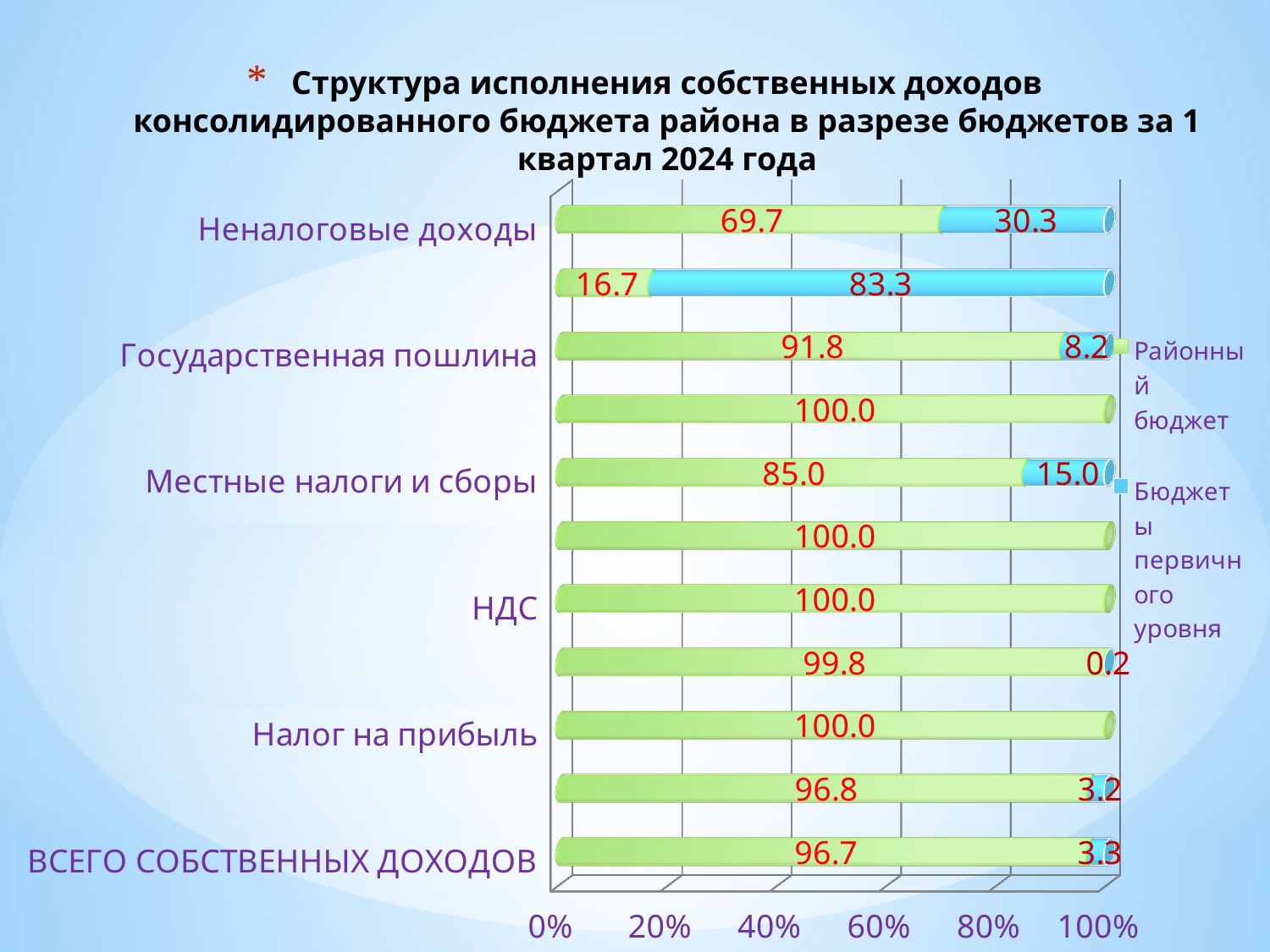
What kind of chart is shown on the slide? Stacked bar chart Among the labeled categories, which has the highest Бюджеты первичного уровня value? Неналоговые доходы What is the value of Районный бюджет for НДС? 100.0 What is the value of Районный бюджет for ВСЕГО СОБСТВЕННЫХ ДОХОДОВ? 96.7 What is the value of Бюджеты первичного уровня for Неналоговые доходы? 30.3 What is the value of Районный бюджет for Местные налоги и сборы? 85.0 What is the total of the stacked bar for Неналоговые доходы? 100.0 How many series does the legend list? 2 What is the value of Бюджеты первичного уровня for Государственная пошлина? 8.2 What is the difference between the Районный бюджет and Бюджеты первичного уровня values for Местные налоги и сборы? 70.0 What is the value of Районный бюджет for Неналоговые доходы? 69.7 Which is larger for Государственная пошлина: Районный бюджет or Бюджеты первичного уровня? Районный бюджет